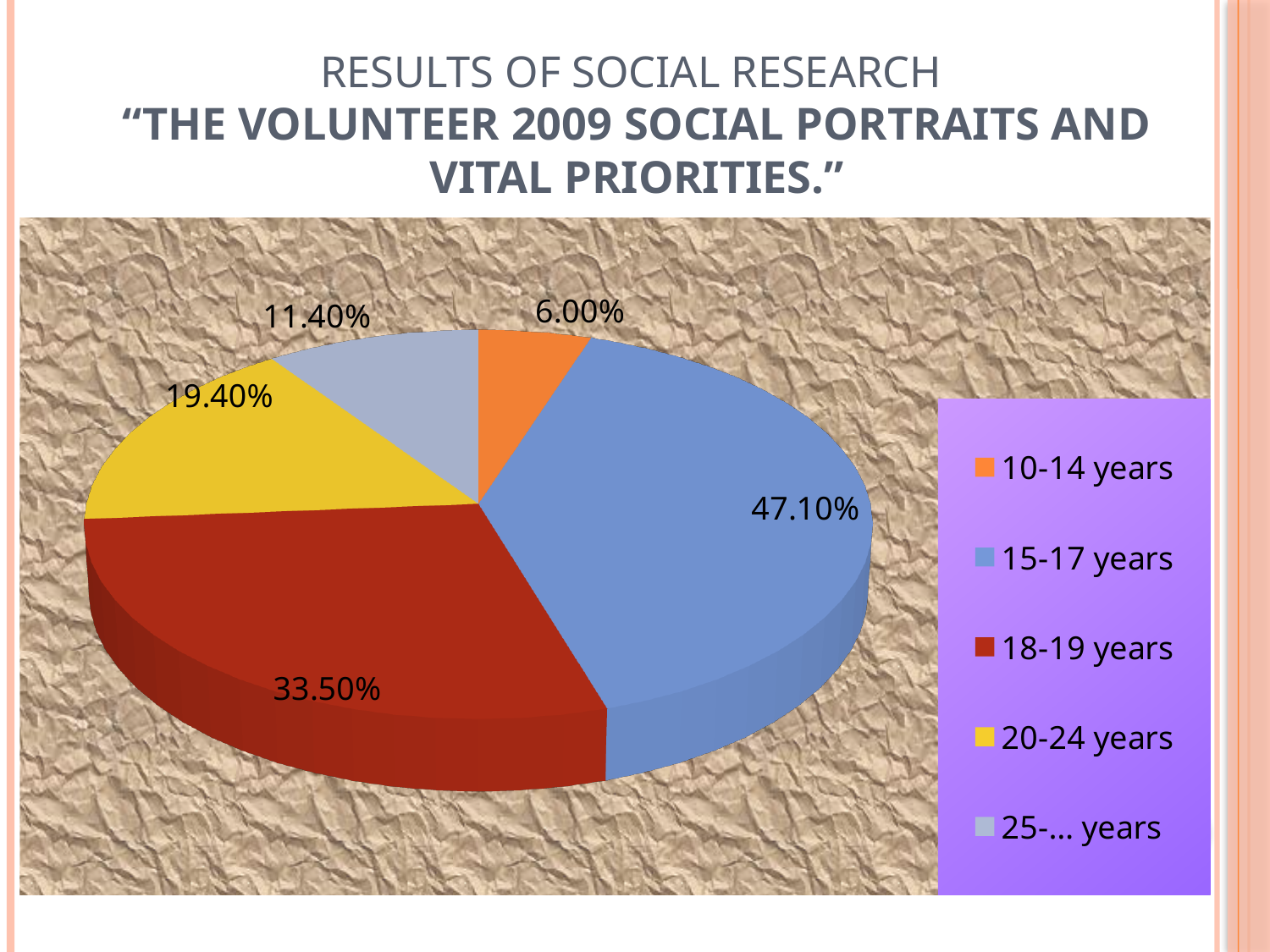
What share of the pie is the 25-... years slice? 11.40% What is the difference in percentage points between the 15-17 years slice and the 18-19 years slice? 13.60% What share of the pie is the 20-24 years slice? 19.40% What kind of chart is shown on the slide? Pie chart Which slice is larger, 20-24 years or 25-... years? 20-24 years What share of the pie is the 10-14 years slice? 6.00% What colour is the 18-19 years slice in the pie chart? Red How many slices does the pie chart have? 5 What share of the pie is the 18-19 years slice? 33.50% What share of the pie is the 15-17 years slice? 47.10% Which age group has the smallest slice of the pie? 10-14 years Which age group has the largest slice of the pie? 15-17 years